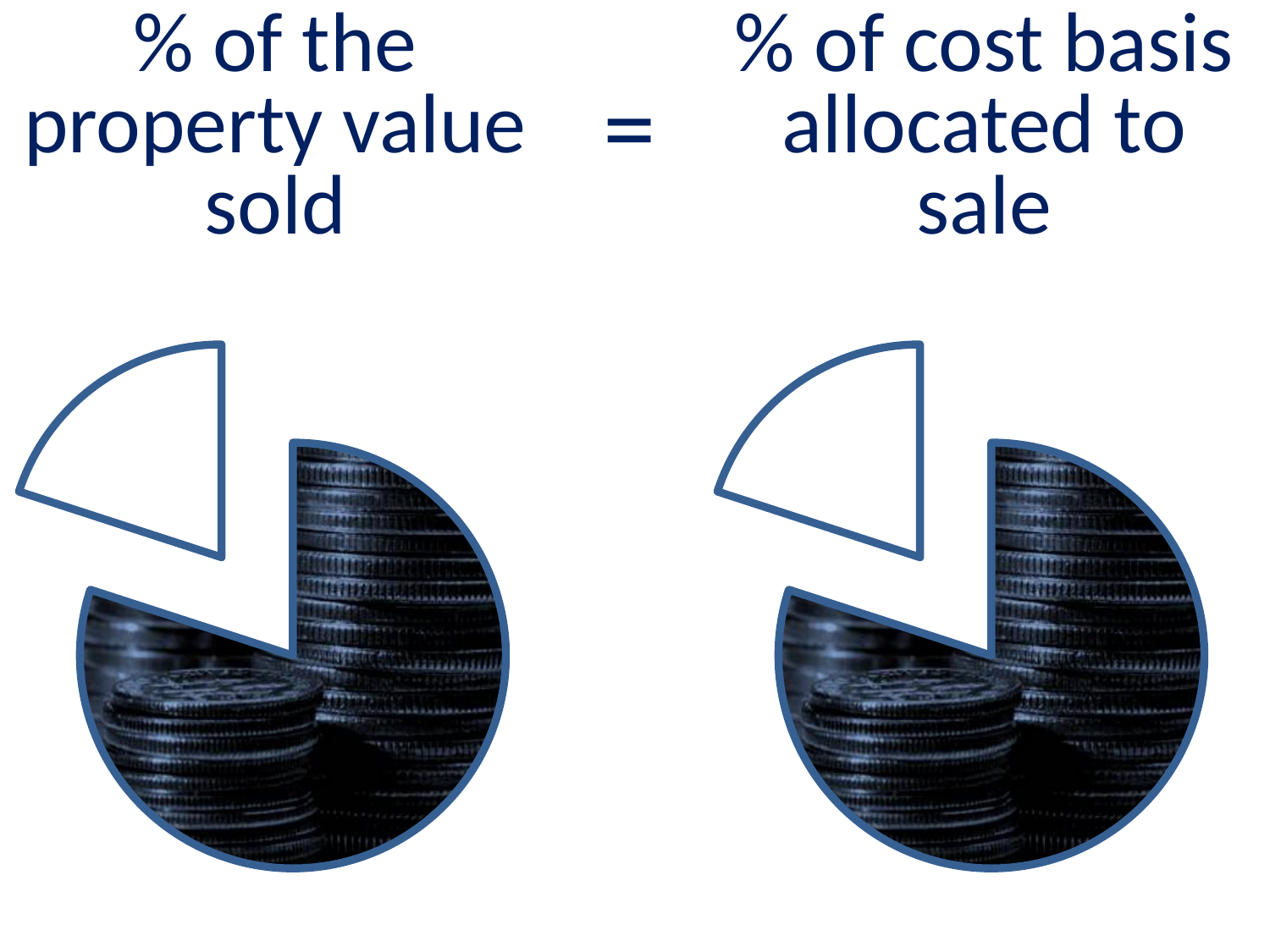
What kind of chart is shown on the left side of the slide? pie chart How many pie charts are on the slide? 2 In the right pie chart, which slice is larger: the exploded white slice or the coin-filled slice? the coin-filled slice How many slices does the left pie chart have? 2 What kind of chart is shown on the right side of the slide? pie chart What is the title above the left pie chart? % of the property value sold How many slices does the right pie chart have? 2 In the left pie chart, which slice is larger: the exploded white slice or the coin-filled slice? the coin-filled slice What is the title above the right pie chart? % of cost basis allocated to sale